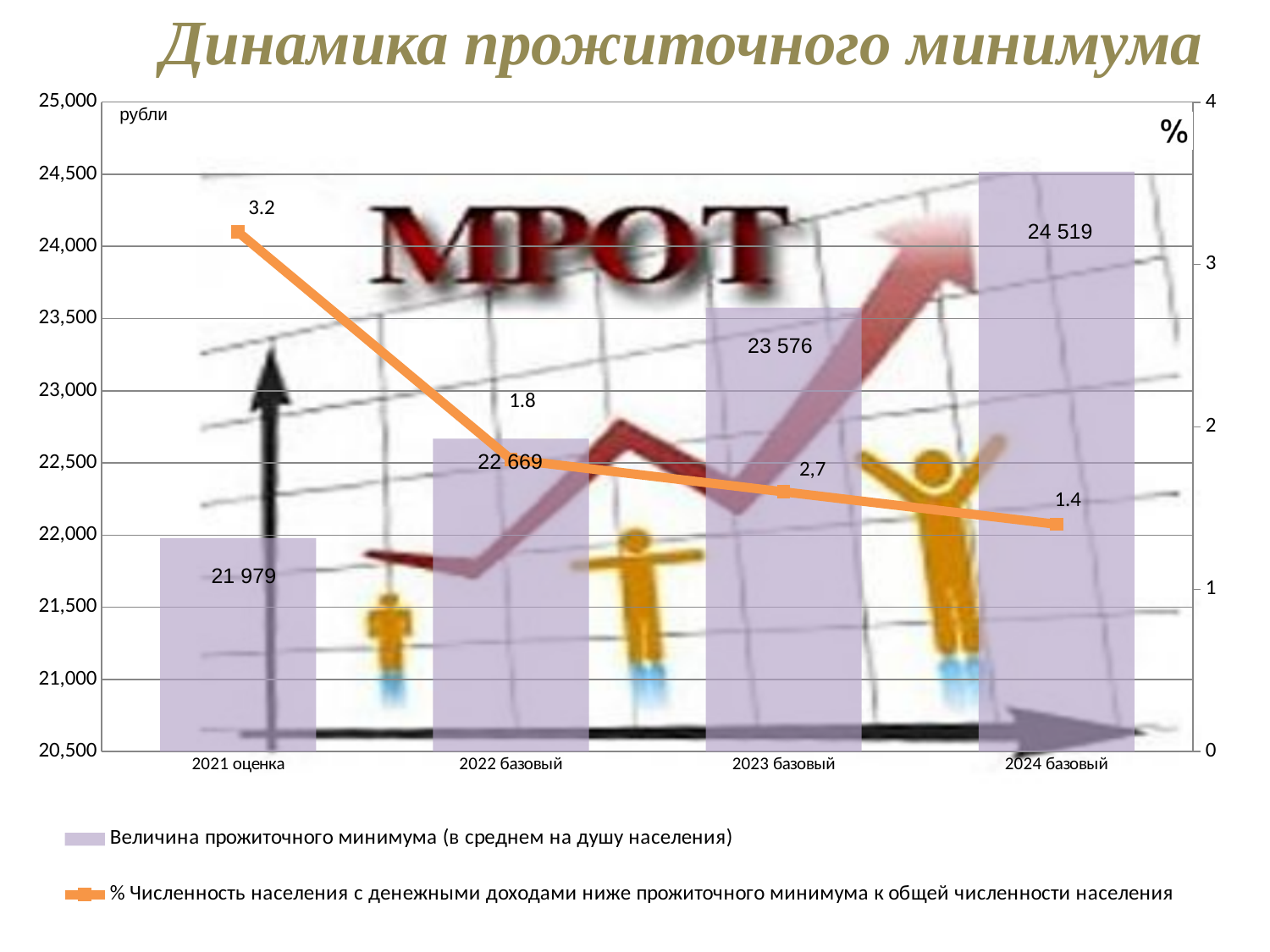
How many series does the legend list? 2 How many categories are shown on the x axis? 4 What is the value of the subsistence minimum for 2022 базовый? 22 669 What is the percentage of population with incomes below the subsistence minimum for 2024 базовый? 1.4 Which category has the lowest subsistence minimum value? 2021 оценка Which category has the highest subsistence minimum value? 2024 базовый What is the value of the subsistence minimum for 2021 оценка? 21 979 What is the value of the subsistence minimum for 2023 базовый? 23 576 Do the subsistence minimum bars rise or fall from 2021 to 2024? rise What is the percentage of population with incomes below the subsistence minimum for 2021 оценка? 3.2 What is the difference between the subsistence minimum for 2024 базовый and 2021 оценка? 2 540 What is the value of the subsistence minimum (Величина прожиточного минимума) for 2024 базовый? 24 519